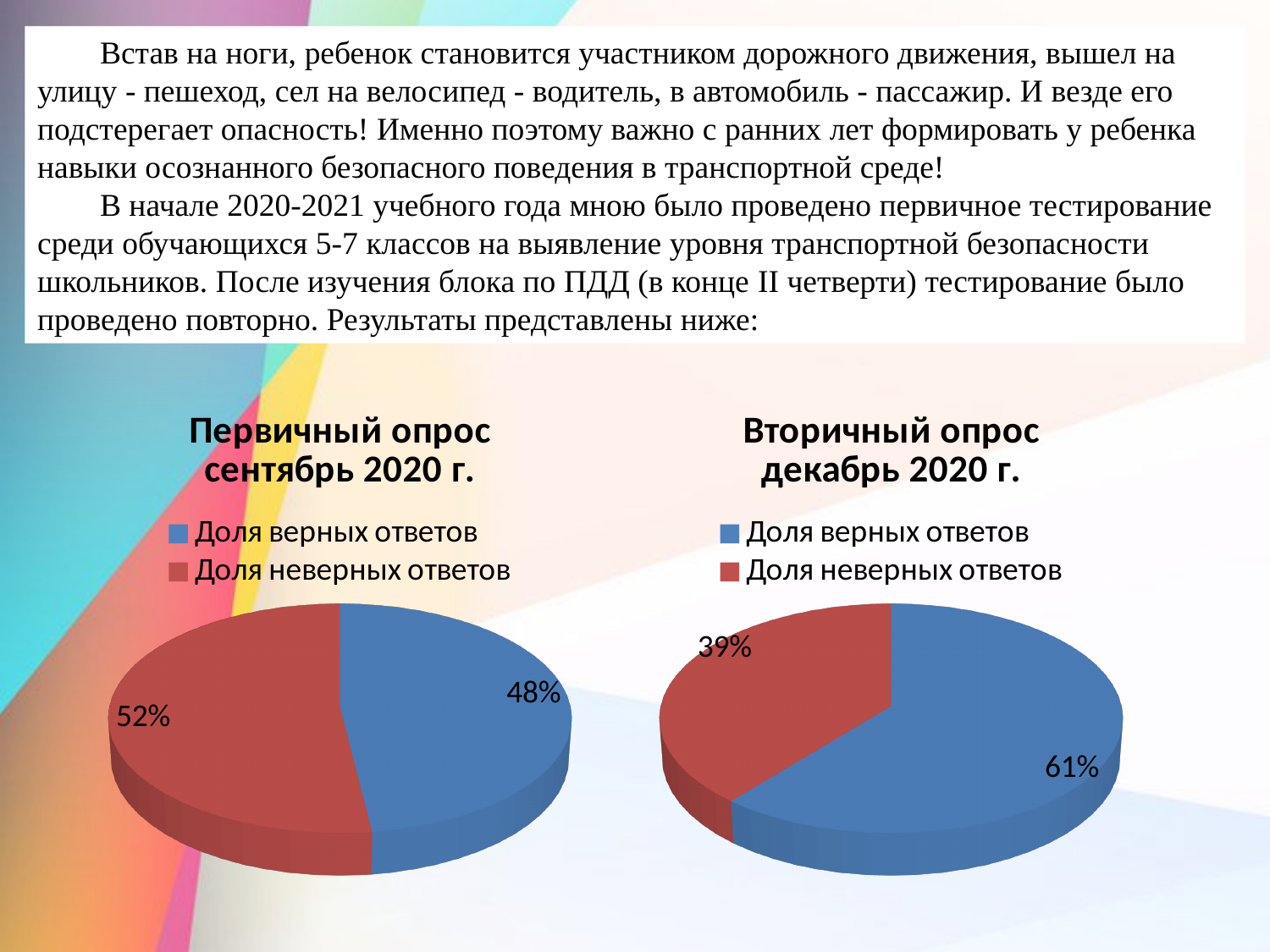
How many slices does the chart titled "Вторичный опрос декабрь 2020 г." have? 2 By how many percentage points did the share of correct answers increase from the chart "Первичный опрос сентябрь 2020 г." to the chart "Вторичный опрос декабрь 2020 г."? 13% In the chart titled "Вторичный опрос декабрь 2020 г.", what is the difference between the share of correct and incorrect answers? 22% In the chart titled "Вторичный опрос декабрь 2020 г.", what is the share of incorrect answers (Доля неверных ответов)? 39% In the chart titled "Вторичный опрос декабрь 2020 г.", what is the share of correct answers (Доля верных ответов)? 61% In the chart titled "Вторичный опрос декабрь 2020 г.", which slice is the smallest? Доля неверных ответов Is the share of correct answers larger in the chart "Первичный опрос сентябрь 2020 г." or in the chart "Вторичный опрос декабрь 2020 г."? Вторичный опрос декабрь 2020 г. What type of chart is used for "Первичный опрос сентябрь 2020 г."? Pie chart In the chart titled "Первичный опрос сентябрь 2020 г.", what is the share of correct answers (Доля верных ответов)? 48% In the chart titled "Первичный опрос сентябрь 2020 г.", what is the share of incorrect answers (Доля неверных ответов)? 52% In the chart titled "Первичный опрос сентябрь 2020 г.", what colour represents "Доля верных ответов"? Blue In the chart titled "Первичный опрос сентябрь 2020 г.", which slice is larger: correct answers or incorrect answers? Доля неверных ответов